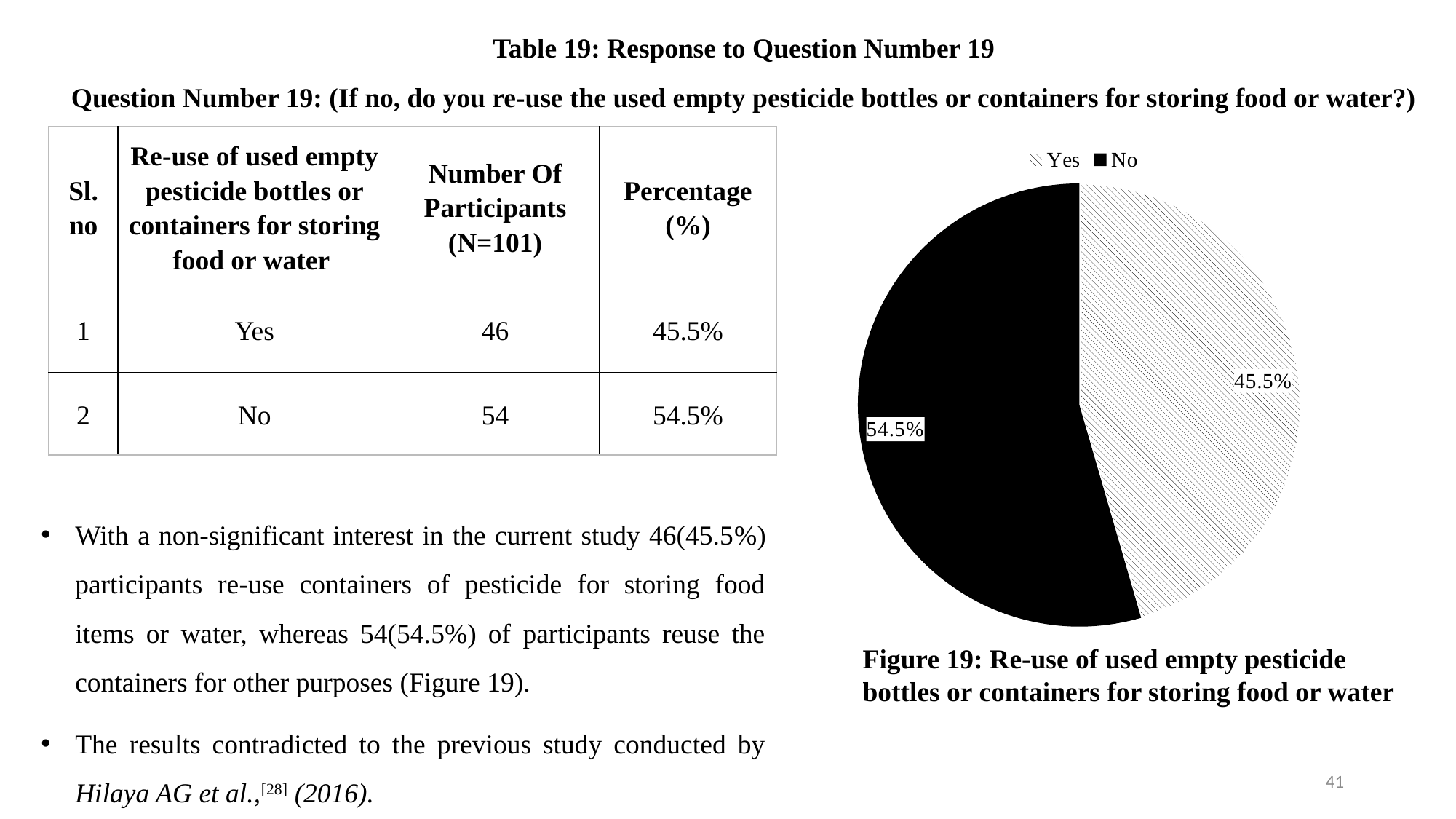
What share of the pie does the No slice represent? 54.5% In the pie chart, what percentage is shown for the Yes slice? 45.5% In the pie chart, which slice is filled solid black? No What type of chart is shown in Figure 19? pie chart In the pie chart, what percentage is shown for the No slice? 54.5% What is the title of the figure containing the pie chart? Figure 19: Re-use of used empty pesticide bottles or containers for storing food or water Which slice of the pie chart is the largest? No Which slice of the pie chart is the smallest? Yes What is the difference in percentage points between the No slice and the Yes slice in the pie chart? 9 percentage points How many entries does the legend of the pie chart list? 2 In the pie chart, which is larger, the Yes slice or the No slice? No How many slices does the pie chart have? 2